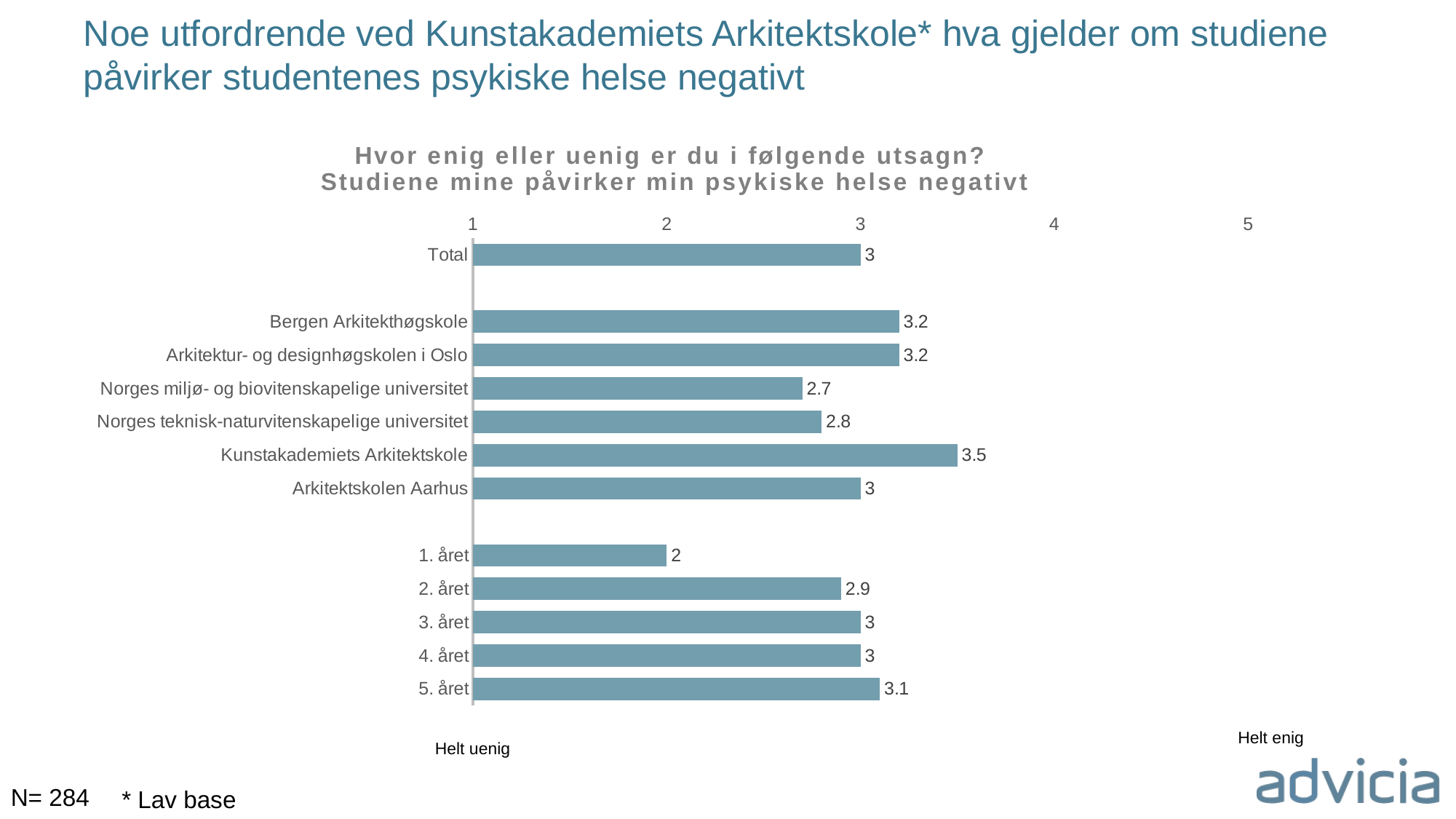
What is the value for Kunstakademiets Arkitektskole? 3.5 What is the difference between the values for Kunstakademiets Arkitektskole and Norges miljø- og biovitenskapelige universitet? 0.8 What is the value for Norges miljø- og biovitenskapelige universitet? 2.7 How many bars are plotted in the chart? 12 Which category has the highest value? Kunstakademiets Arkitektskole What is the value for 1. året? 2 What label appears at the left end of the axis, below the value 1? Helt uenig What is the value for Total? 3 Which is larger, the value for 2. året or the value for 5. året? 5. året Which category has the lowest value? 1. året Is the value for Bergen Arkitekthøgskole greater or less than 3? greater What kind of chart is shown on the slide? bar chart